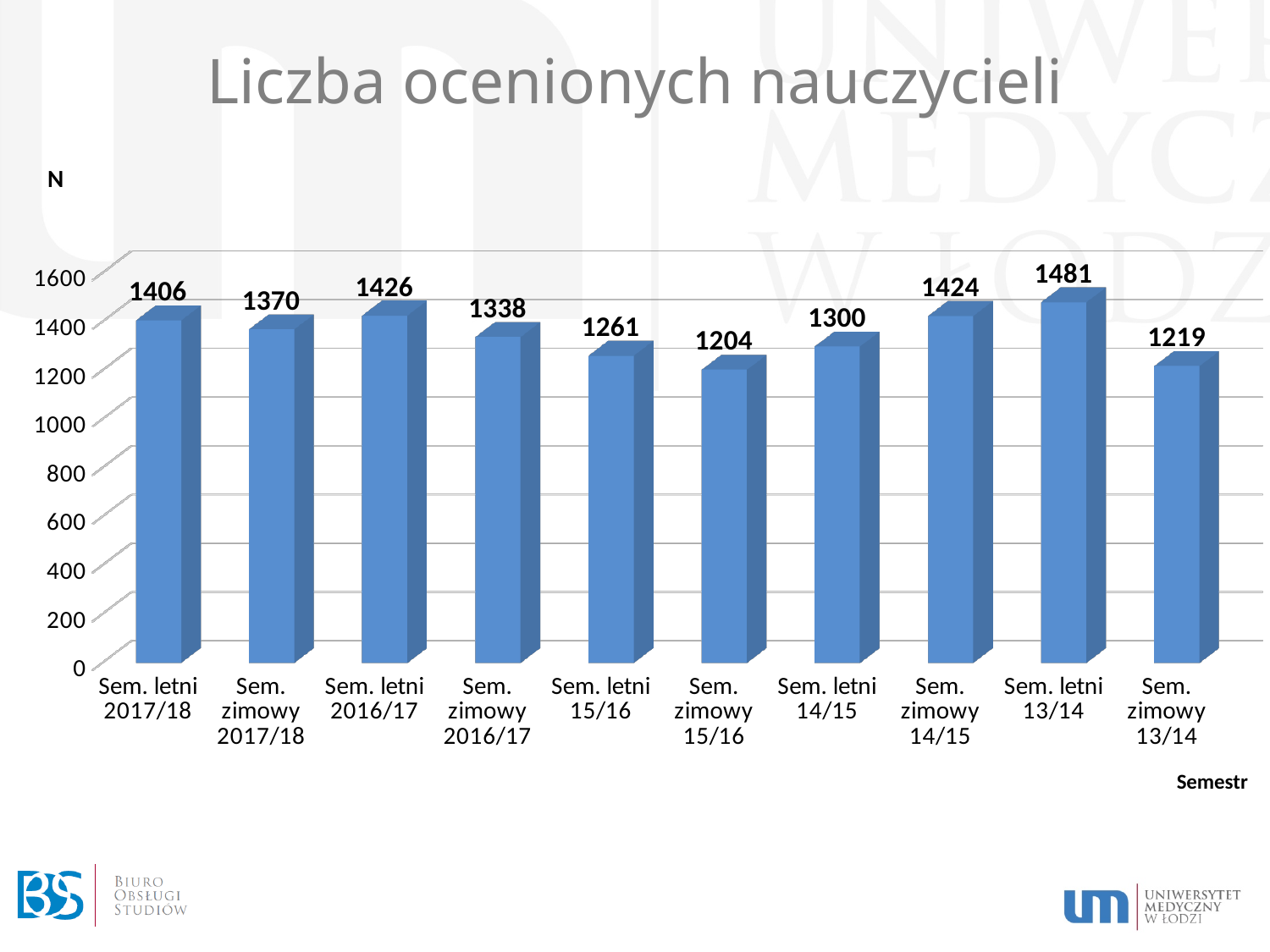
Which semester has the lowest number of evaluated teachers? Sem. zimowy 15/16 What kind of chart is shown on the slide? bar chart How many semesters are shown on the chart? 10 What is the difference between the values for Sem. letni 2016/17 and Sem. zimowy 2016/17? 88 What is the title of the chart? Liczba ocenionych nauczycieli What is the value for Sem. letni 13/14? 1481 Which semester has the highest number of evaluated teachers? Sem. letni 13/14 Which is larger, the value for Sem. letni 14/15 or Sem. zimowy 13/14? Sem. letni 14/15 Is the value for Sem. zimowy 14/15 greater or less than 1400? greater What is the value for Sem. letni 2017/18? 1406 What is the label of the x axis? Semestr What is the value for Sem. zimowy 15/16? 1204